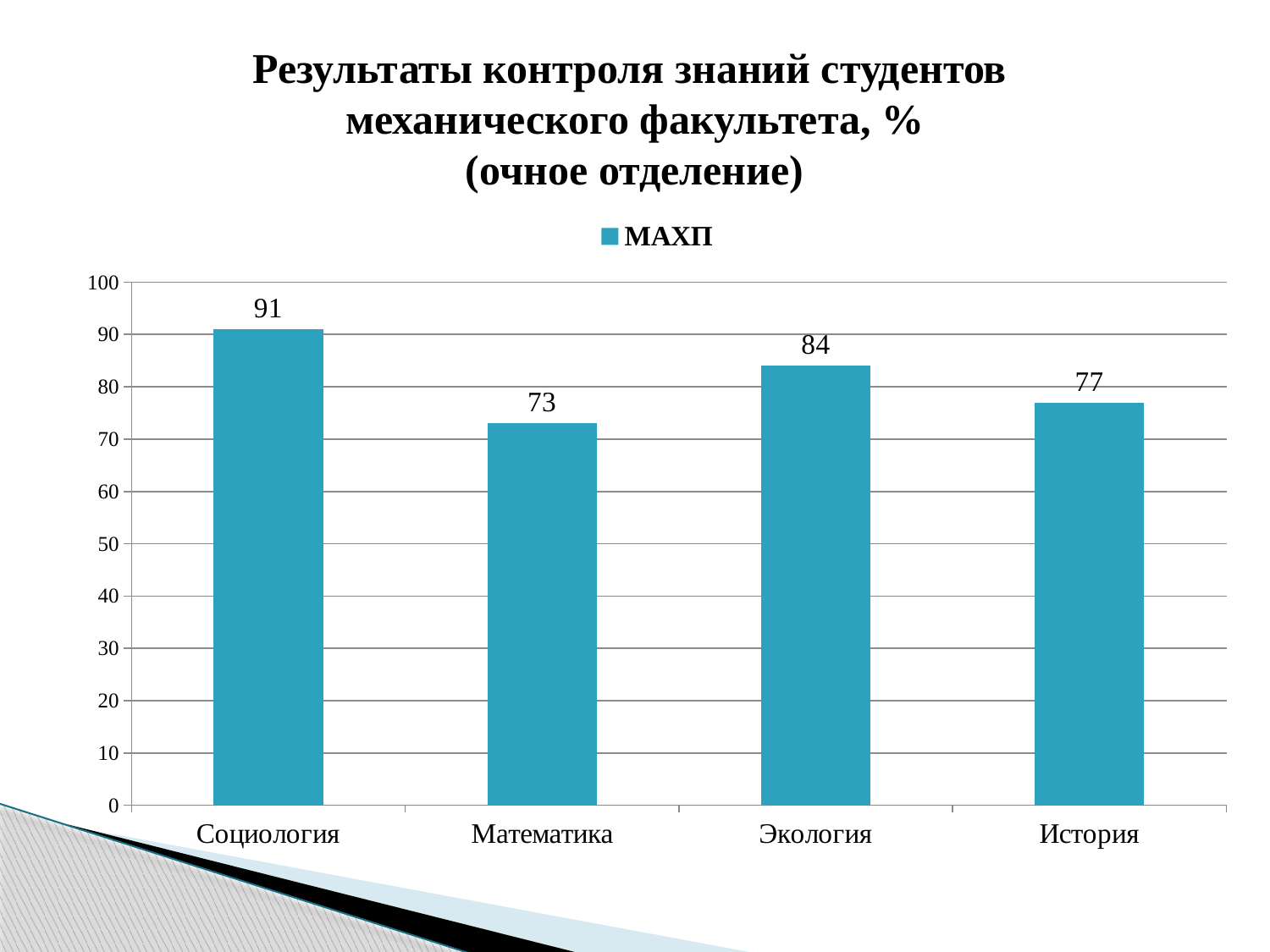
What kind of chart is shown on the slide? bar chart What series name does the legend show? МАХП What is the value for Экология? 84 Which is larger, the value for Экология or the value for История? Экология What is the value for История? 77 What is the value for Социология? 91 Which category has the highest value? Социология How many categories are shown on the x axis? 4 What is the value for Математика? 73 Which category has the lowest value? Математика Is the value for История greater or less than 80? less What is the difference between the values for Социология and Математика? 18